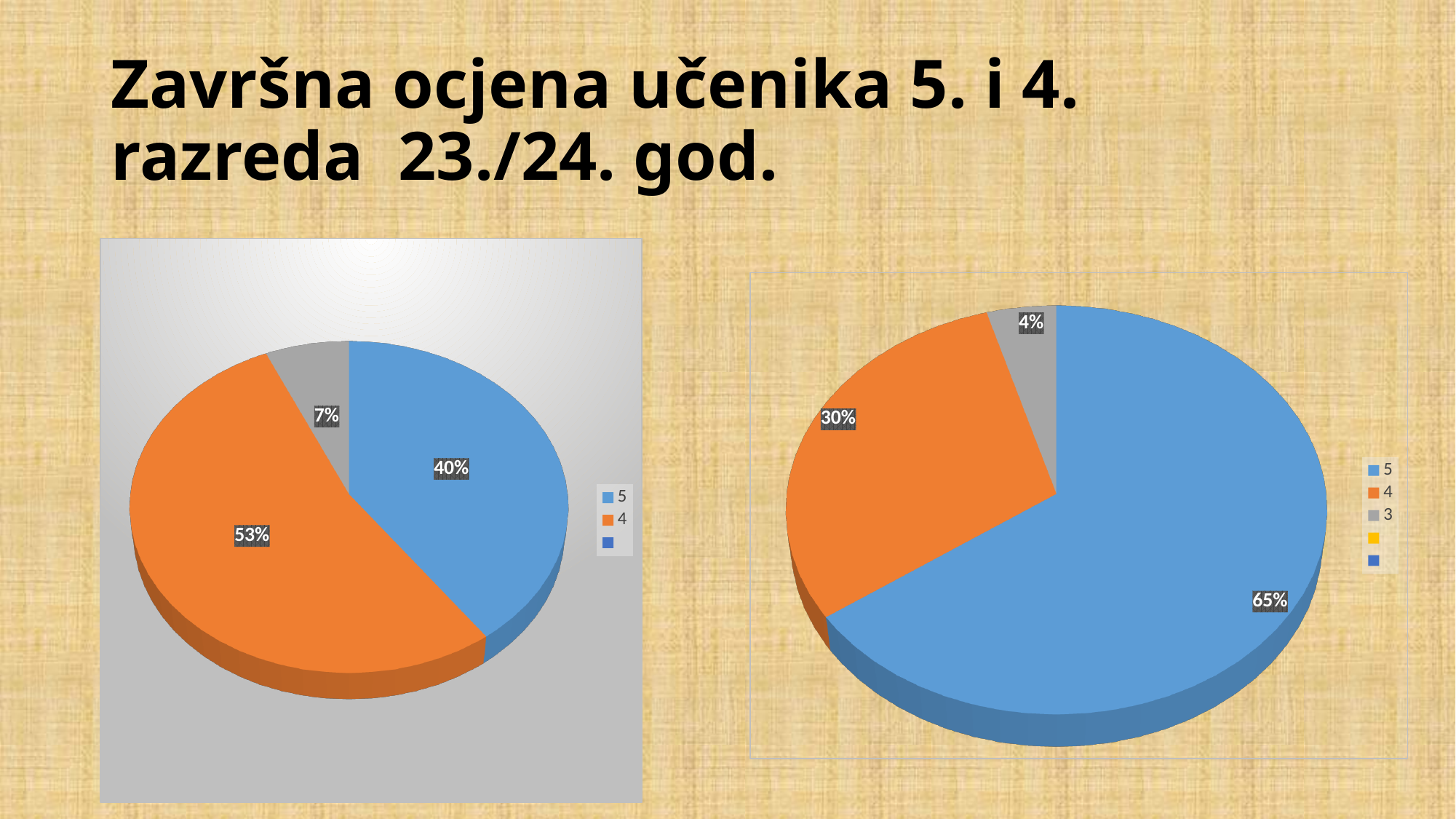
In the left pie chart, what is the difference in percentage points between category 4 and category 5? 13 percentage points In the right pie chart, which is larger, category 5 or category 4? 5 In the left pie chart, what share does the grey slice have? 7% In the right pie chart, what percentage is shown for category 4? 30% In the right pie chart, what percentage is shown for category 5? 65% In the left pie chart, what percentage is shown for category 5? 40% In the left pie chart, which category has the largest slice? 4 In the right pie chart, what percentage is shown for category 3? 4% In the right pie chart, what is the difference in percentage points between category 5 and category 4? 35 percentage points In the right pie chart, which category has the smallest slice? 3 What type of chart is the right chart on the slide? Pie chart In the left pie chart, what percentage is shown for category 4? 53%